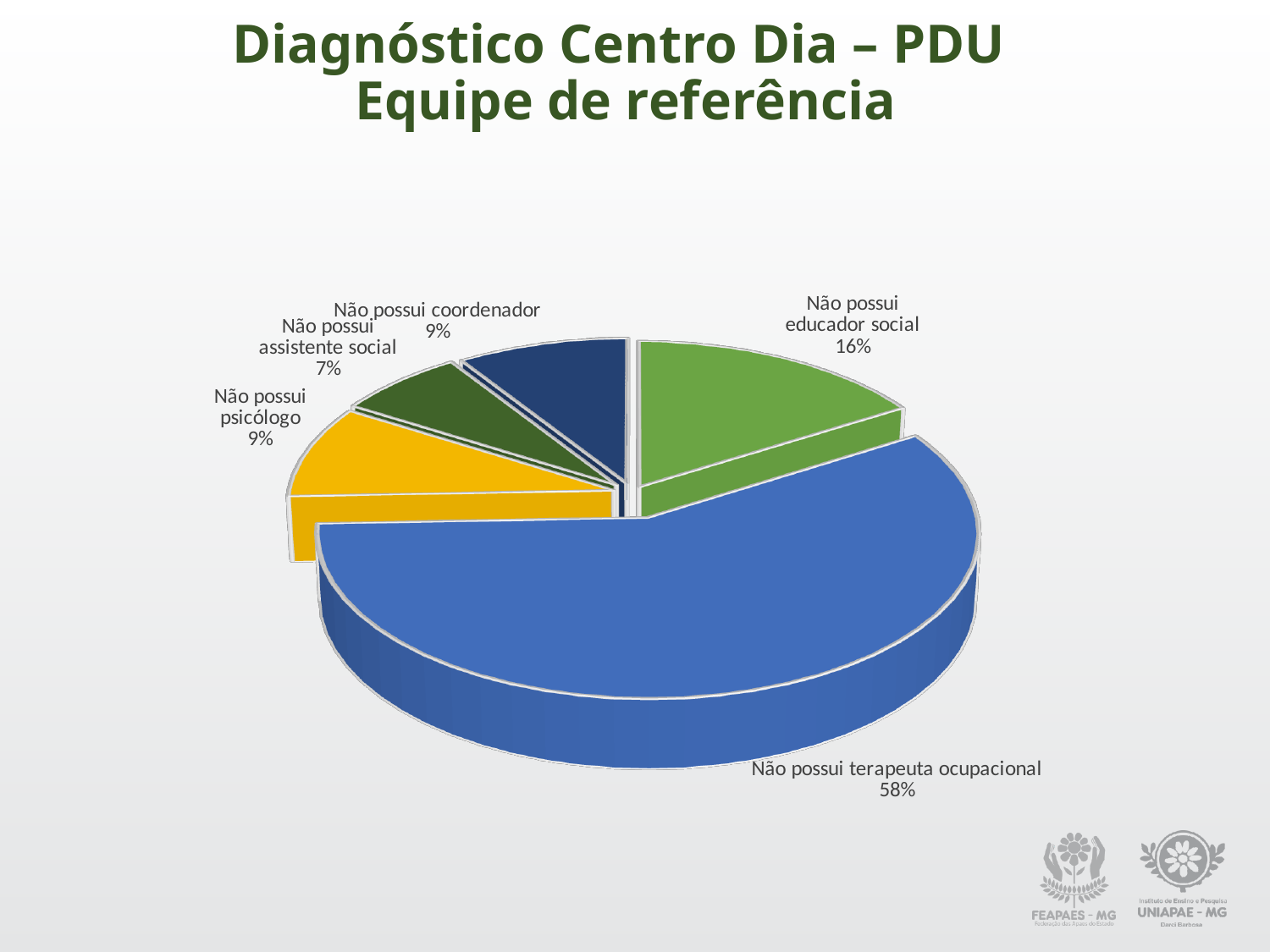
What is the value for "Não possui coordenador"? 9% What is the value for "Não possui psicólogo"? 9% What is the value for "Não possui educador social"? 16% How many slices does the pie chart have? 5 What is the value for "Não possui assistente social"? 7% Which category has the smallest slice of the pie? Não possui assistente social What is the difference between the values for "Não possui terapeuta ocupacional" and "Não possui educador social"? 42% What kind of chart is shown on the slide? pie chart Which is larger, the value for "Não possui educador social" or the value for "Não possui psicólogo"? Não possui educador social What colour is the slice for "Não possui psicólogo"? yellow Which category has the largest slice of the pie? Não possui terapeuta ocupacional What share of the pie is labelled "Não possui terapeuta ocupacional"? 58%